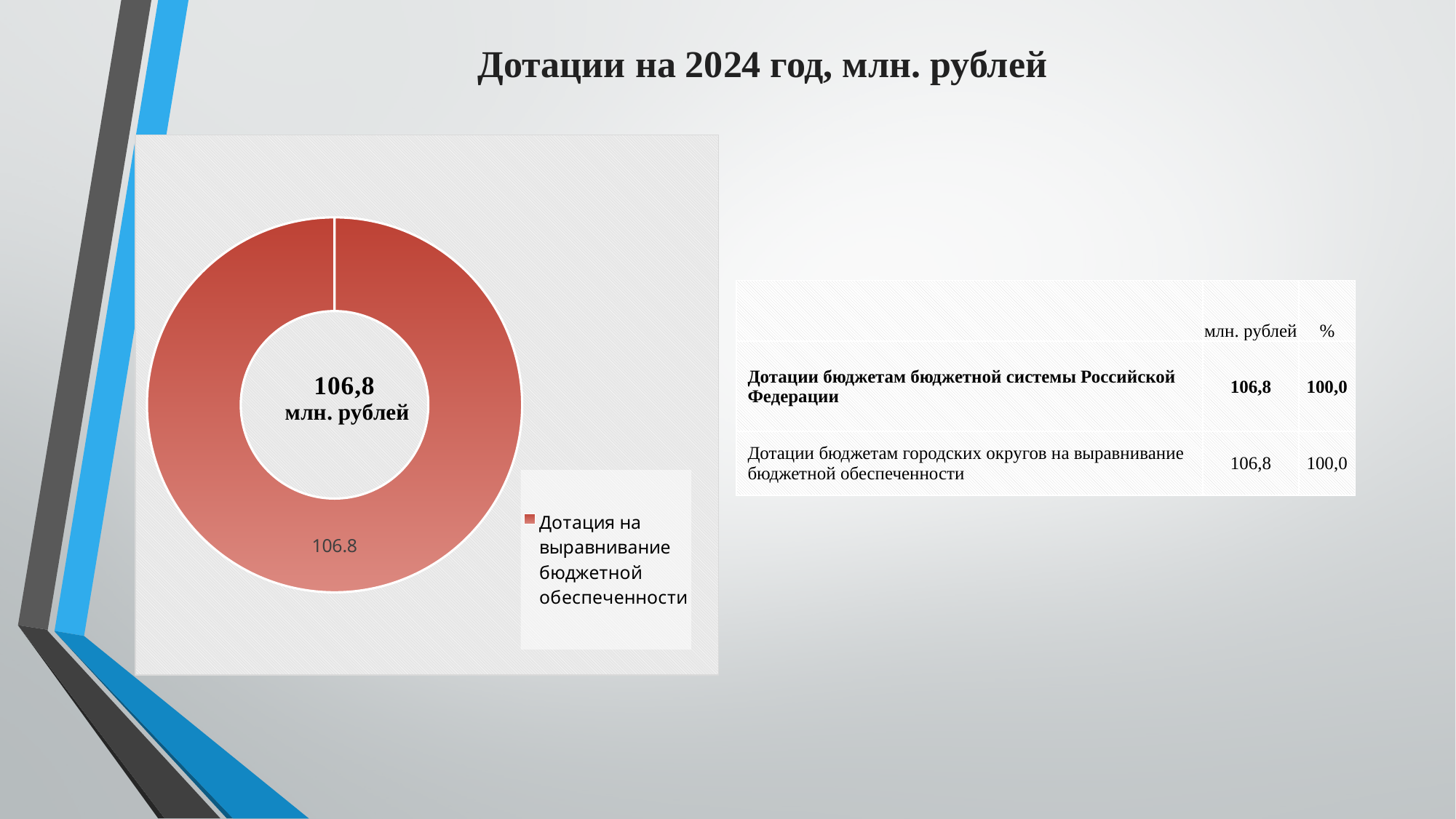
What share of the doughnut chart does the "Дотация на выравнивание бюджетной обеспеченности" slice take up? 100% How many entries does the chart legend list? 1 What kind of chart is shown on the slide? Doughnut (pie) chart What value is shown as the data label on the doughnut chart slice? 106.8 How many slices does the doughnut chart have? 1 What is the value for "Дотация на выравнивание бюджетной обеспеченности" on the chart? 106.8 What is the title of the slide containing the chart? Дотации на 2024 год, млн. рублей What text is printed in the centre of the doughnut chart? 106,8 млн. рублей What is the legend entry of the doughnut chart? Дотация на выравнивание бюджетной обеспеченности